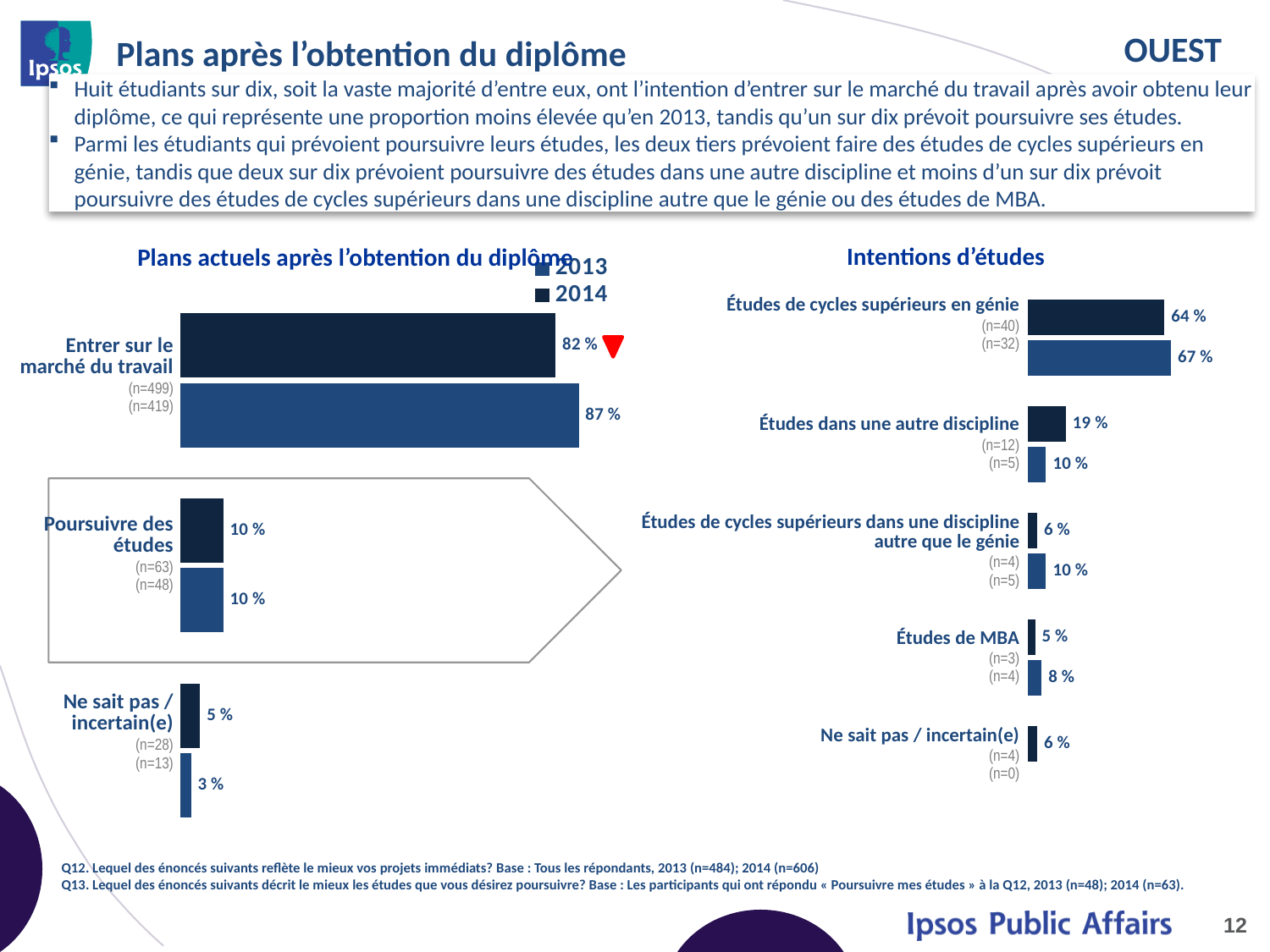
In the 'Plans actuels après l'obtention du diplôme' chart, for 'Entrer sur le marché du travail', which bar is larger, the dark navy one or the lighter blue one? The lighter blue one (87 %) In the 'Plans actuels après l'obtention du diplôme' chart, how many categories are shown? 3 In the 'Intentions d'études' chart, what is the value of the dark navy bar for 'Études dans une autre discipline'? 19 % What kind of chart is the 'Plans actuels après l'obtention du diplôme' chart? Bar chart How many series does the legend on the slide list? 2 What is the title of the chart on the right side of the slide? Intentions d'études In the 'Plans actuels après l'obtention du diplôme' chart, what is the value of the dark navy bar for 'Entrer sur le marché du travail'? 82 % In the 'Intentions d'études' chart, how many categories are shown? 5 In the 'Plans actuels après l'obtention du diplôme' chart, what is the value of the lighter blue bar for 'Ne sait pas / incertain(e)'? 3 % In the 'Intentions d'études' chart, what is the difference between the two bars for 'Études de cycles supérieurs en génie'? 3 % In the 'Intentions d'études' chart, which category has the highest values? Études de cycles supérieurs en génie In the 'Intentions d'études' chart, what is the value of the lighter blue bar for 'Études de MBA'? 8 %